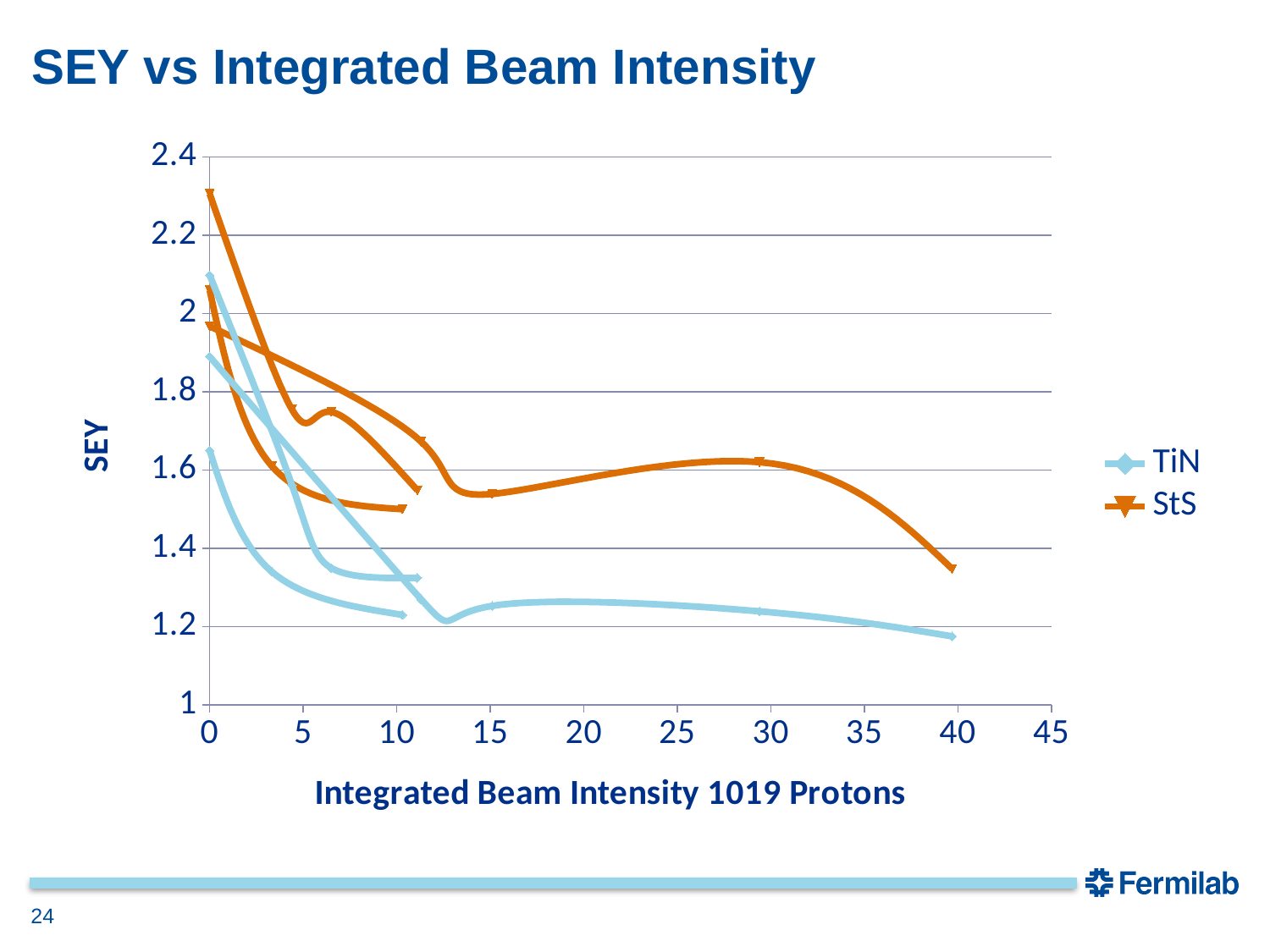
Is the SEY value for TiN at an integrated beam intensity of about 40 greater or less than 1.4? less Which series reaches the lowest SEY value on the chart? TiN How many series does the legend list? 2 What is the title of the chart? SEY vs Integrated Beam Intensity What kind of chart is shown on the slide? line chart Overall, does SEY rise or fall as integrated beam intensity increases? fall At an integrated beam intensity of about 40, which series has the higher SEY, TiN or StS? StS What is the label of the x axis? Integrated Beam Intensity 1019 Protons Is the SEY value for StS at an integrated beam intensity of about 40 greater or less than 1.6? less Which series reaches the highest SEY value on the chart? StS Is the highest starting SEY value for StS at an integrated beam intensity of 0 greater or less than 2.2? greater How many curves are plotted for the StS series? 3